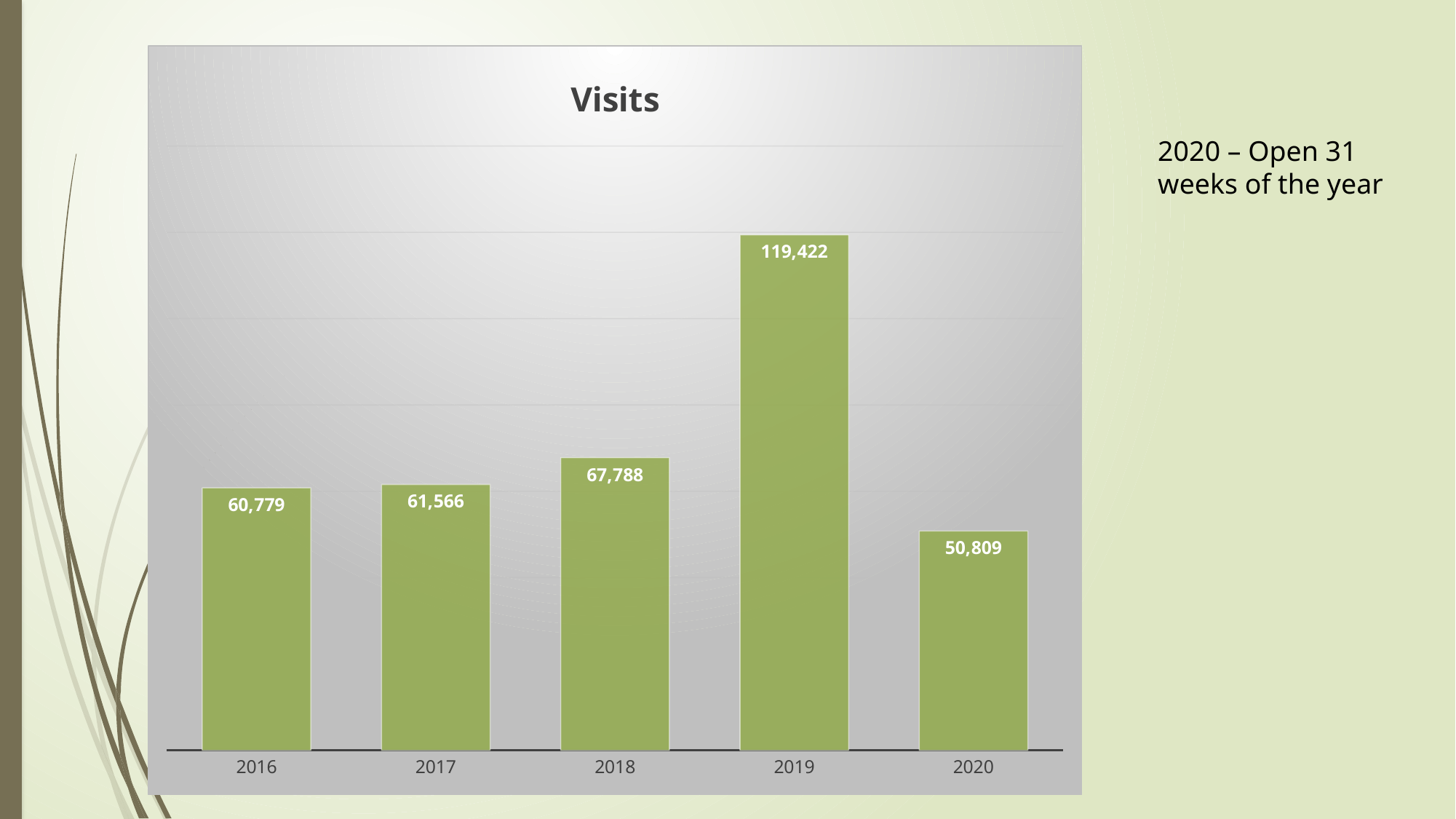
What is the difference in visits between 2017 and 2016? 787 What is the value for 2016 in the Visits chart? 60,779 What is the value for 2020 in the Visits chart? 50,809 What is the title of the chart? Visits What kind of chart is shown on the slide? Bar chart Which year had more visits, 2018 or 2020? 2018 What is the difference in visits between 2019 and 2018? 51,634 Which year has the highest number of visits? 2019 Do visits rise or fall from 2016 to 2018? Rise Which year has the lowest number of visits? 2020 What is the value for 2019 in the Visits chart? 119,422 How many years are shown in the Visits chart? 5